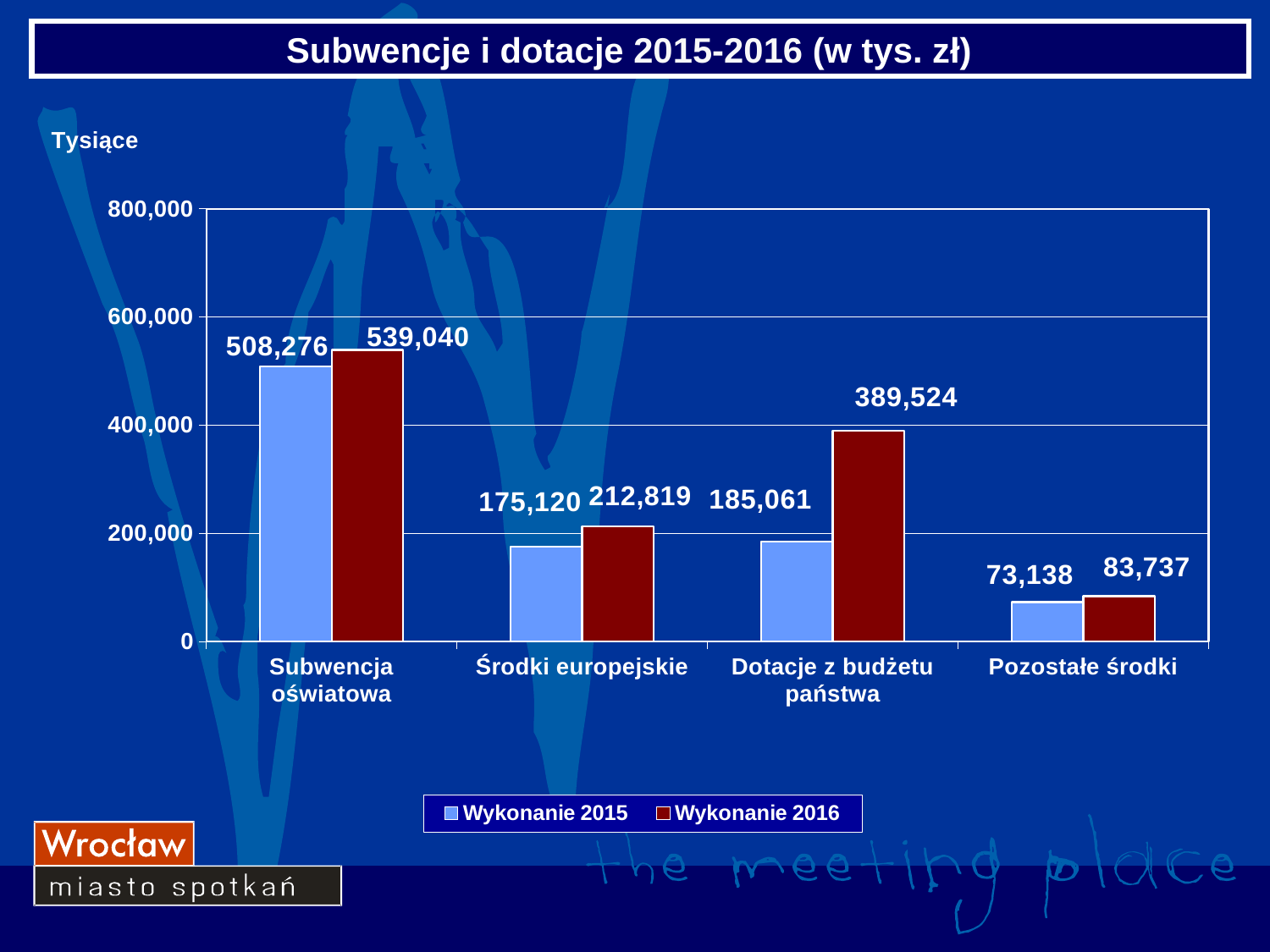
What is the Wykonanie 2016 value for Pozostałe środki? 83,737 What kind of chart is shown on the slide? Bar chart How many series does the legend list? 2 Which category has the highest Wykonanie 2016 value? Subwencja oświatowa What is the difference between the Wykonanie 2016 and Wykonanie 2015 values for Dotacje z budżetu państwa? 204,463 Which is larger: the Wykonanie 2015 value for Środki europejskie or the Wykonanie 2015 value for Dotacje z budżetu państwa? Dotacje z budżetu państwa Which category has the lowest Wykonanie 2015 value? Pozostałe środki What is the Wykonanie 2015 value for Subwencja oświatowa? 508,276 What is the difference between the Wykonanie 2016 and Wykonanie 2015 values for Subwencja oświatowa? 30,764 What is the Wykonanie 2015 value for Środki europejskie? 175,120 How many categories are shown on the x axis? 4 What is the Wykonanie 2016 value for Dotacje z budżetu państwa? 389,524